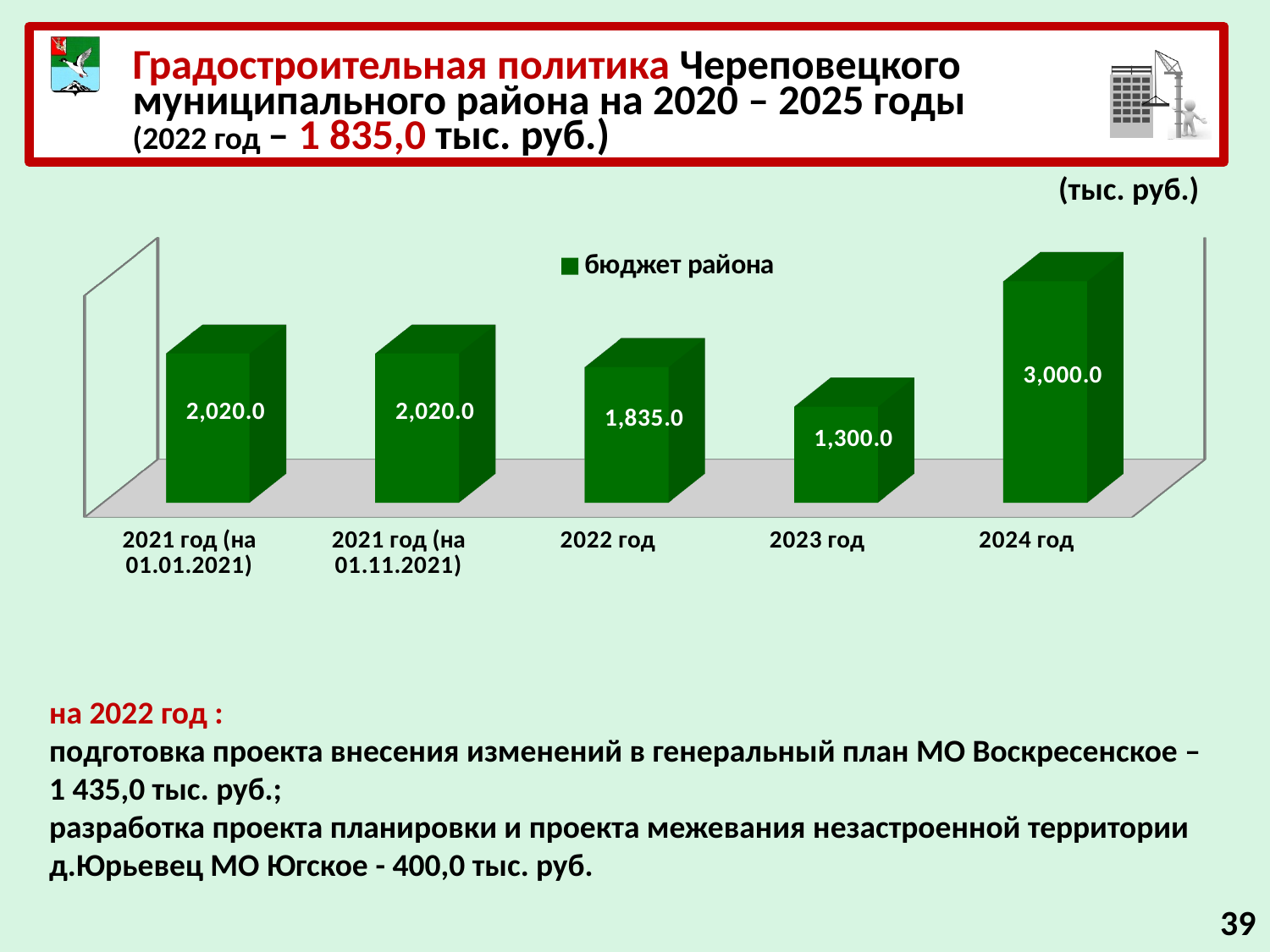
Which is larger, the value for 2022 год or the value for 2023 год? 2022 год How many series does the legend list? 1 What is the value for 2021 год (на 01.01.2021)? 2,020.0 What is the difference between the values for 2021 год (на 01.11.2021) and 2022 год? 185.0 Which category has the lowest value? 2023 год What kind of chart is shown on the slide? bar chart How many categories are shown on the x axis? 5 What is the difference between the values for 2024 год and 2023 год? 1,700.0 Which category has the highest value? 2024 год What is the value for 2022 год? 1,835.0 What is the value for 2024 год? 3,000.0 What is the value for 2023 год? 1,300.0